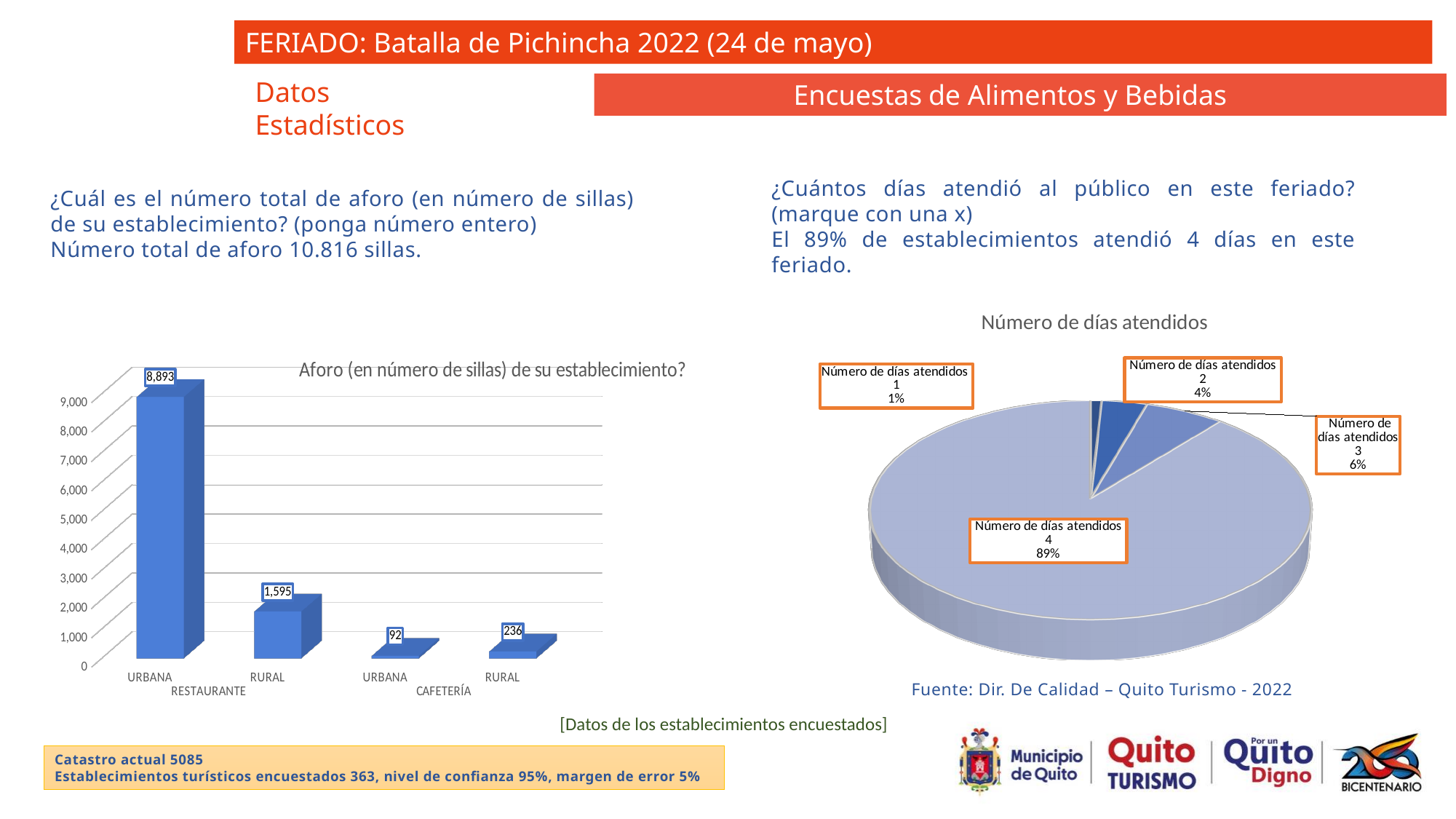
How many bars are plotted in the bar chart 'Aforo (en número de sillas) de su establecimiento?'? 4 In the bar chart 'Aforo (en número de sillas) de su establecimiento?', which category has the highest value? URBANA (RESTAURANTE) In the bar chart 'Aforo (en número de sillas) de su establecimiento?', what is the value for RURAL under CAFETERÍA? 236 In the bar chart 'Aforo (en número de sillas) de su establecimiento?', what is the difference between URBANA RESTAURANTE and RURAL RESTAURANTE? 7,298 In the pie chart 'Número de días atendidos', what share corresponds to 4 days attended? 89% What kind of chart is the chart on the left of the slide? Bar chart In the pie chart 'Número de días atendidos', what share corresponds to 3 days attended? 6% In the bar chart 'Aforo (en número de sillas) de su establecimiento?', which category has the lowest value? URBANA (CAFETERÍA) In the bar chart 'Aforo (en número de sillas) de su establecimiento?', which is larger: RURAL CAFETERÍA or URBANA CAFETERÍA? RURAL CAFETERÍA In the pie chart 'Número de días atendidos', which slice is the smallest? Número de días atendidos 1 What kind of chart is the chart on the right of the slide? Pie chart In the bar chart 'Aforo (en número de sillas) de su establecimiento?', what is the value for URBANA under RESTAURANTE? 8,893